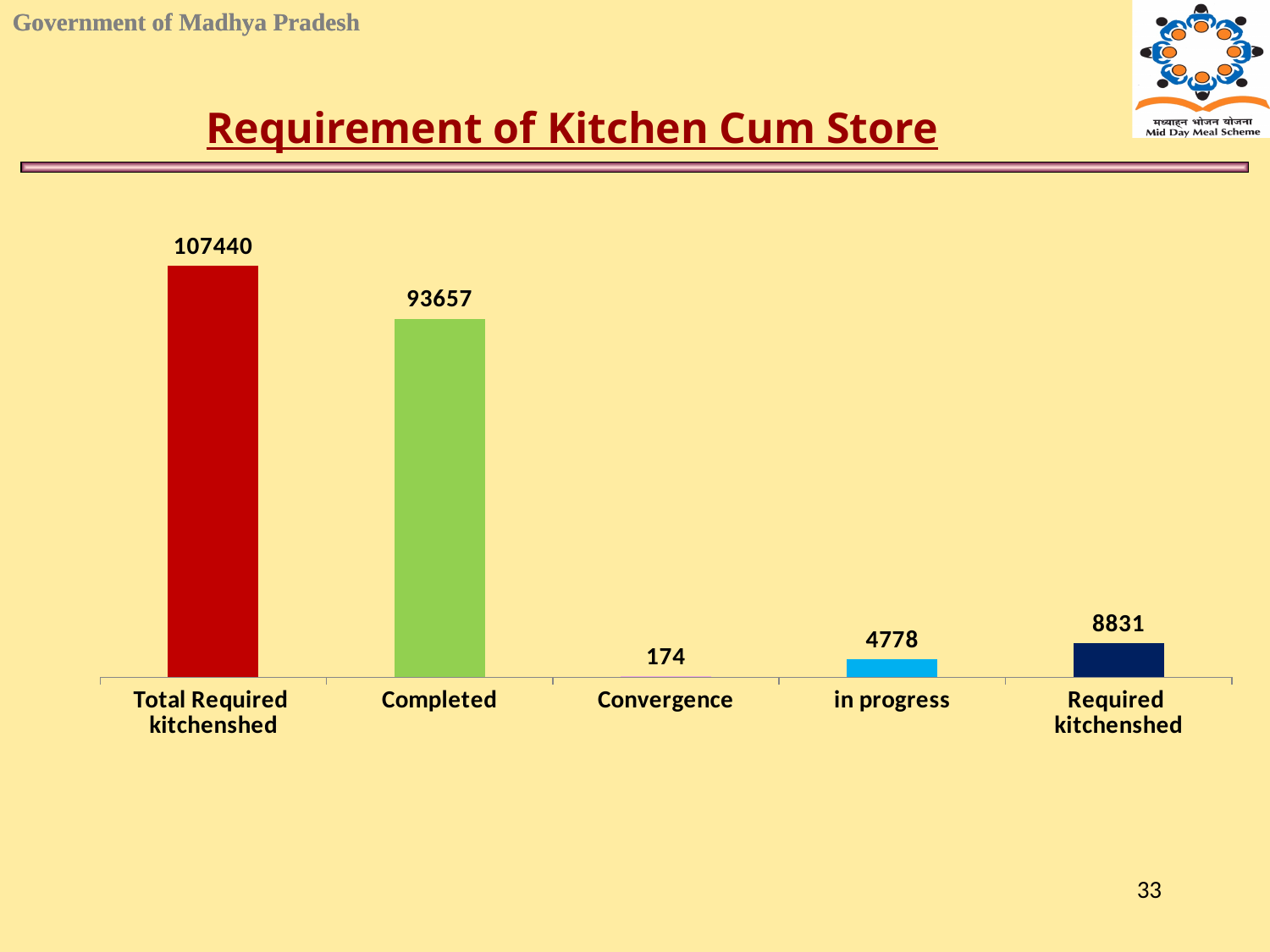
What is the value for Convergence? 174 Which category has the lowest value? Convergence What is the difference between Required kitchenshed and in progress? 4053 What is the value for Completed? 93657 What is the value for in progress? 4778 What is the value for Required kitchenshed? 8831 How many categories are shown in the chart? 5 Which is larger, in progress or Required kitchenshed? Required kitchenshed What kind of chart is shown on the slide? Bar chart What is the difference between Total Required kitchenshed and Completed? 13783 What is the value for Total Required kitchenshed? 107440 Which category has the highest value? Total Required kitchenshed